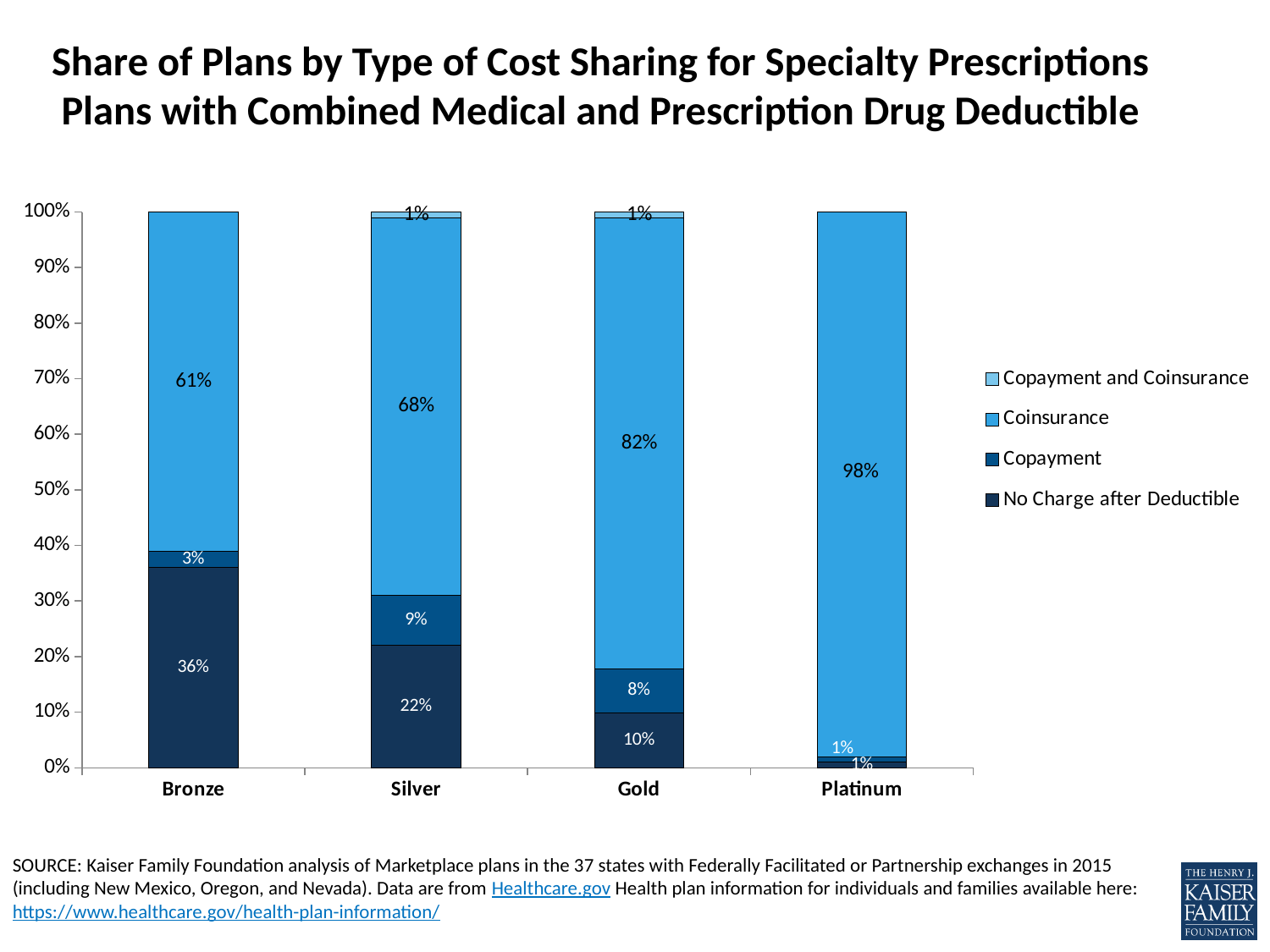
What kind of chart is shown on the slide? Stacked bar chart Which plan type has the lowest No Charge after Deductible share? Platinum Does the No Charge after Deductible share rise or fall from Bronze to Platinum? Fall What is the No Charge after Deductible share for Bronze plans? 36% What is the difference between the Coinsurance share for Platinum and for Bronze? 37% Which plan type has the highest Coinsurance share? Platinum How many series does the legend list? 4 Which is larger: the Copayment share for Silver or for Gold? Silver What is the Copayment and Coinsurance share for Gold plans? 1% What is the Coinsurance share for Gold plans? 82% How many plan types are shown on the x axis? 4 What is the Copayment share for Silver plans? 9%